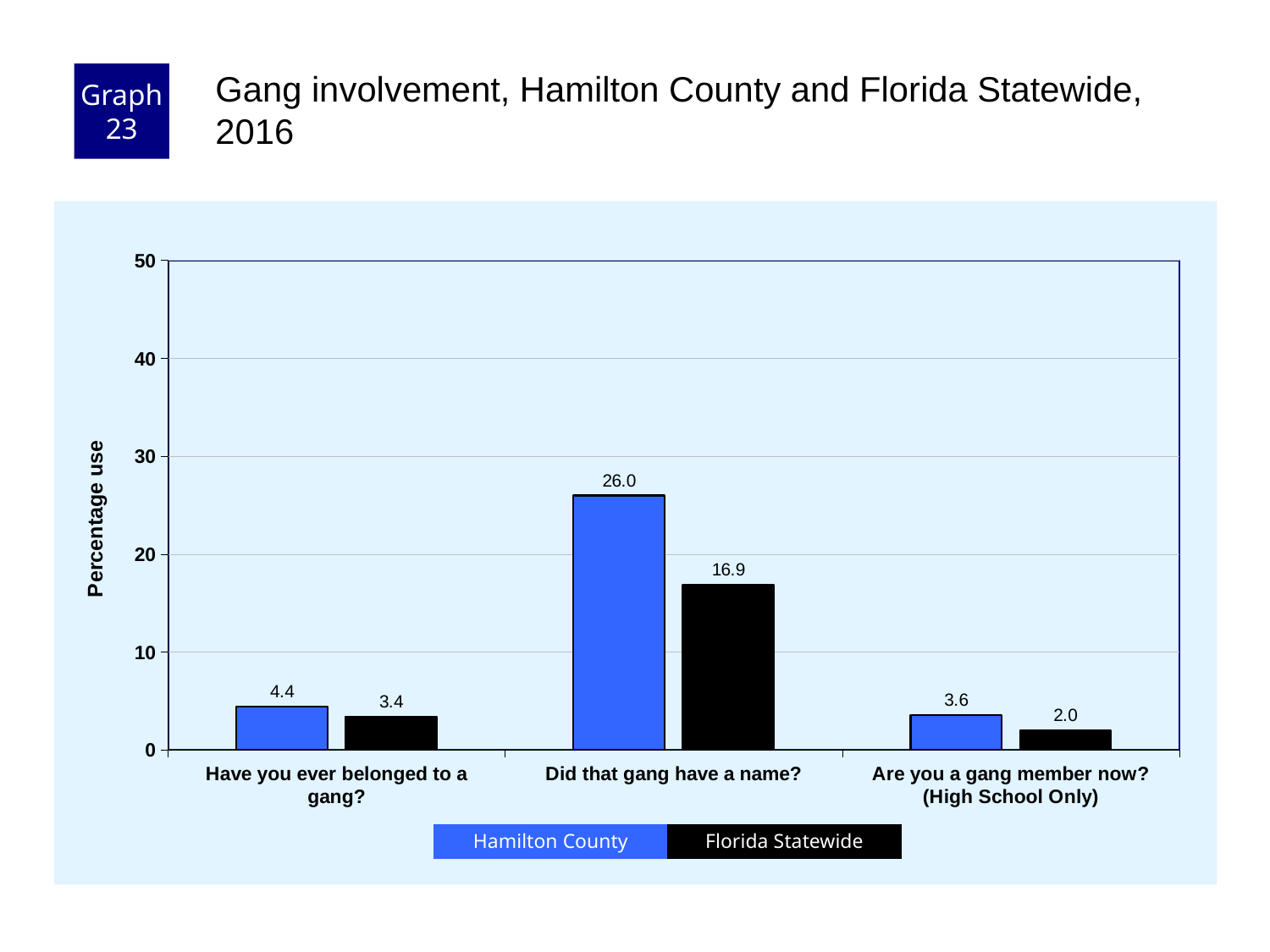
What is the Florida Statewide value for "Have you ever belonged to a gang?"? 3.4 How many question categories are shown on the x axis? 3 Which question has the lowest Florida Statewide value? Are you a gang member now? (High School Only) How many series does the legend list? 2 What kind of chart is shown? bar chart Is the Hamilton County value for "Did that gang have a name?" greater or less than 20? greater What is the label on the y axis? Percentage use Which question has the highest Hamilton County value? Did that gang have a name? What is the difference between the Hamilton County and Florida Statewide values for "Did that gang have a name?"? 9.1 For "Are you a gang member now? (High School Only)", which is larger: Hamilton County or Florida Statewide? Hamilton County What is the Hamilton County value for "Did that gang have a name?"? 26.0 What is the Florida Statewide value for "Are you a gang member now? (High School Only)"? 2.0